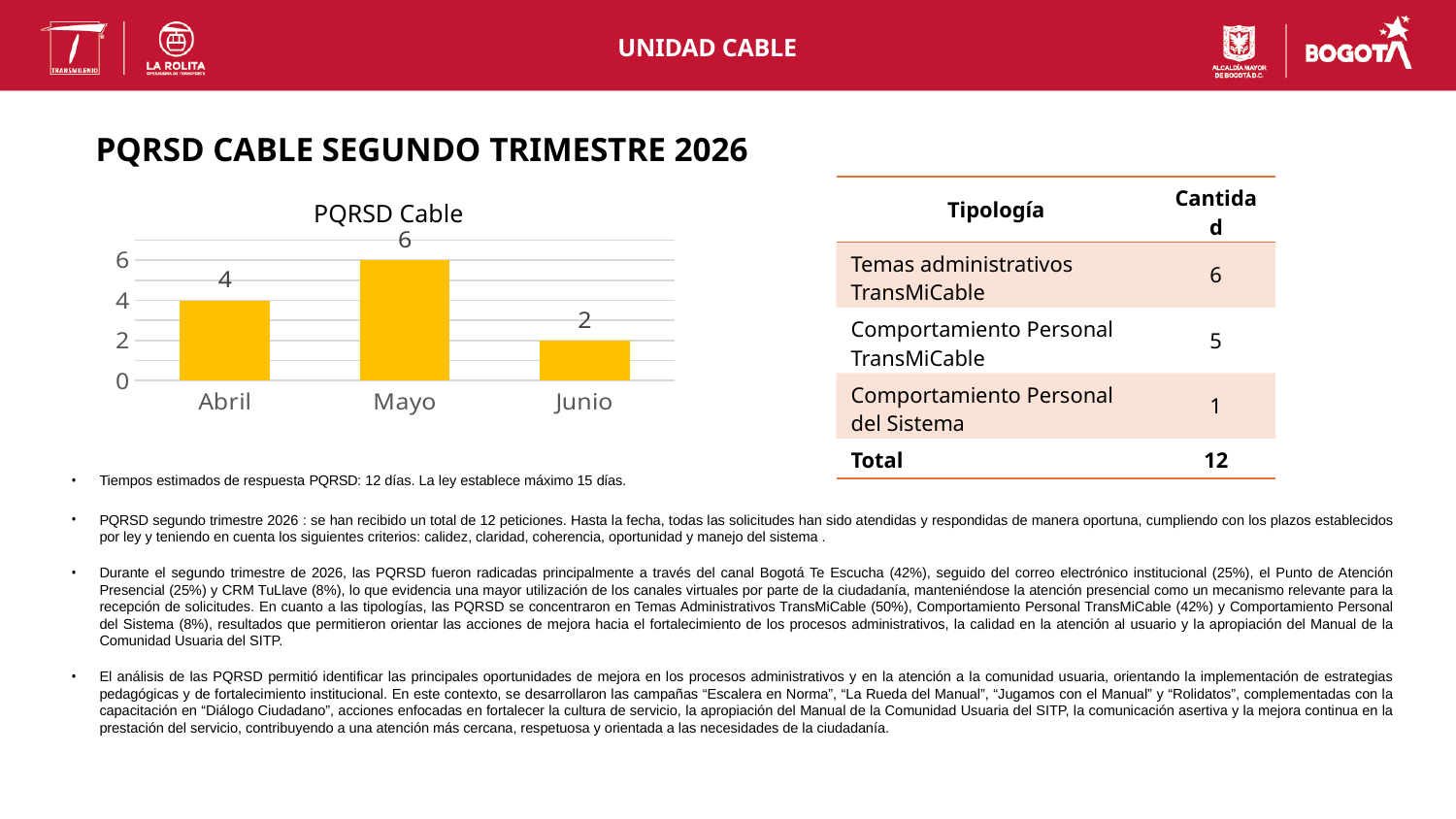
Does the value in the PQRSD Cable chart rise or fall from Mayo to Junio? Fall What kind of chart is the PQRSD Cable chart? Bar chart What is the value for Abril in the PQRSD Cable chart? 4 What is the title of the chart on the slide? PQRSD Cable Which month has the highest value in the PQRSD Cable chart? Mayo What is the difference between the values for Mayo and Junio in the PQRSD Cable chart? 4 What is the value for Junio in the PQRSD Cable chart? 2 What is the value for Mayo in the PQRSD Cable chart? 6 Which is larger in the PQRSD Cable chart, the value for Abril or the value for Junio? Abril Which month has the lowest value in the PQRSD Cable chart? Junio What is the difference between the values for Mayo and Abril in the PQRSD Cable chart? 2 How many months are shown on the x axis of the PQRSD Cable chart? 3